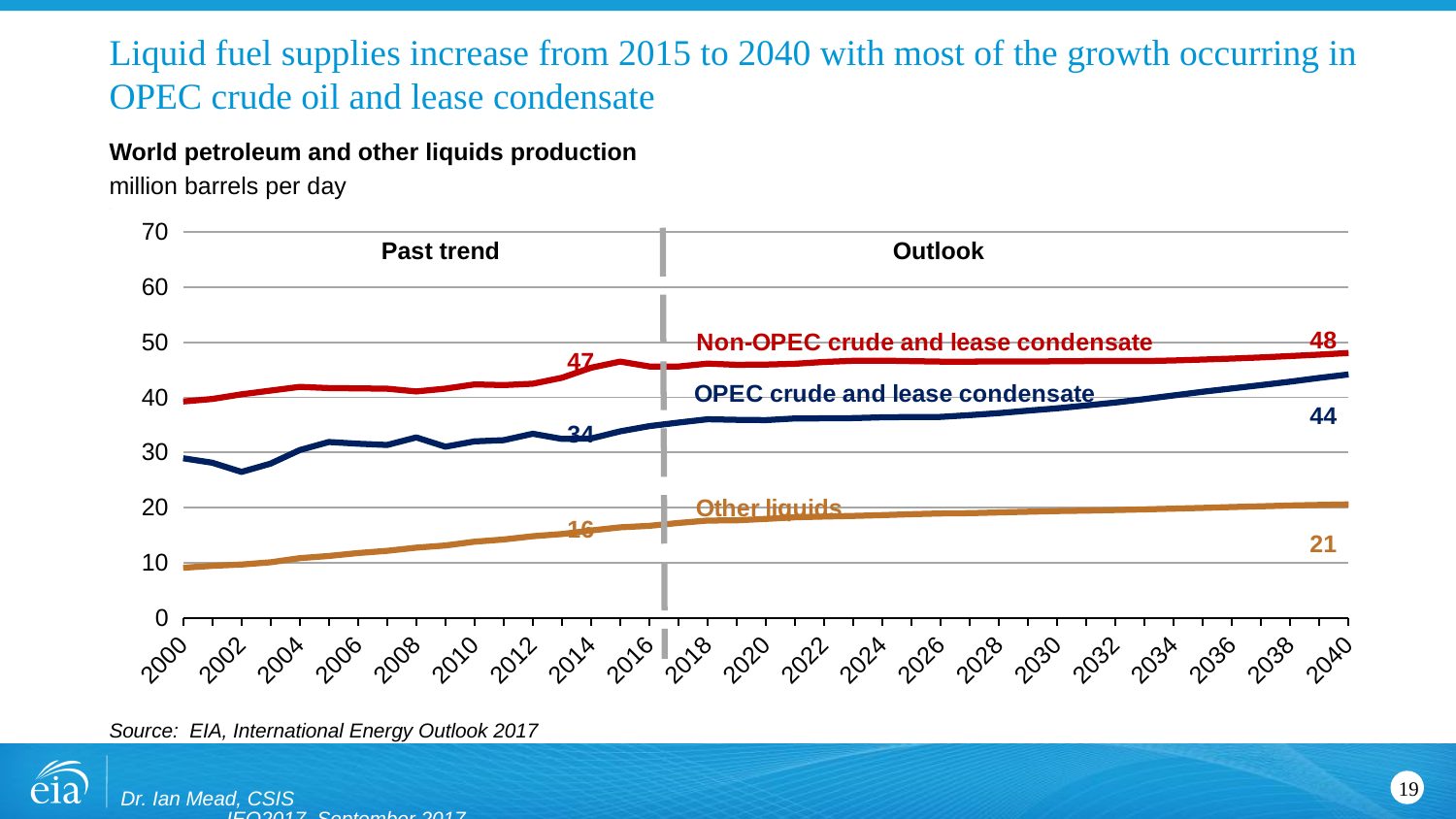
What kind of chart is shown on the slide? line chart Is the value for OPEC crude and lease condensate in 2002 greater or less than 30? less What is the labeled value for OPEC crude and lease condensate in 2040? 44 What is the labeled value for OPEC crude and lease condensate at the 2015 point? 34 By how much does OPEC crude and lease condensate production increase from its 2015 label (34) to its 2040 label (44)? 10 What is the labeled value for Other liquids in 2040? 21 By how much does Other liquids production increase from its 2015 label (16) to its 2040 label (21)? 5 What unit is the chart measured in? million barrels per day How many series are plotted on the chart? 3 In 2040, which is larger: Non-OPEC crude and lease condensate or OPEC crude and lease condensate? Non-OPEC crude and lease condensate What is the labeled value for Non-OPEC crude and lease condensate in 2040? 48 Which series has the lowest value in 2040? Other liquids